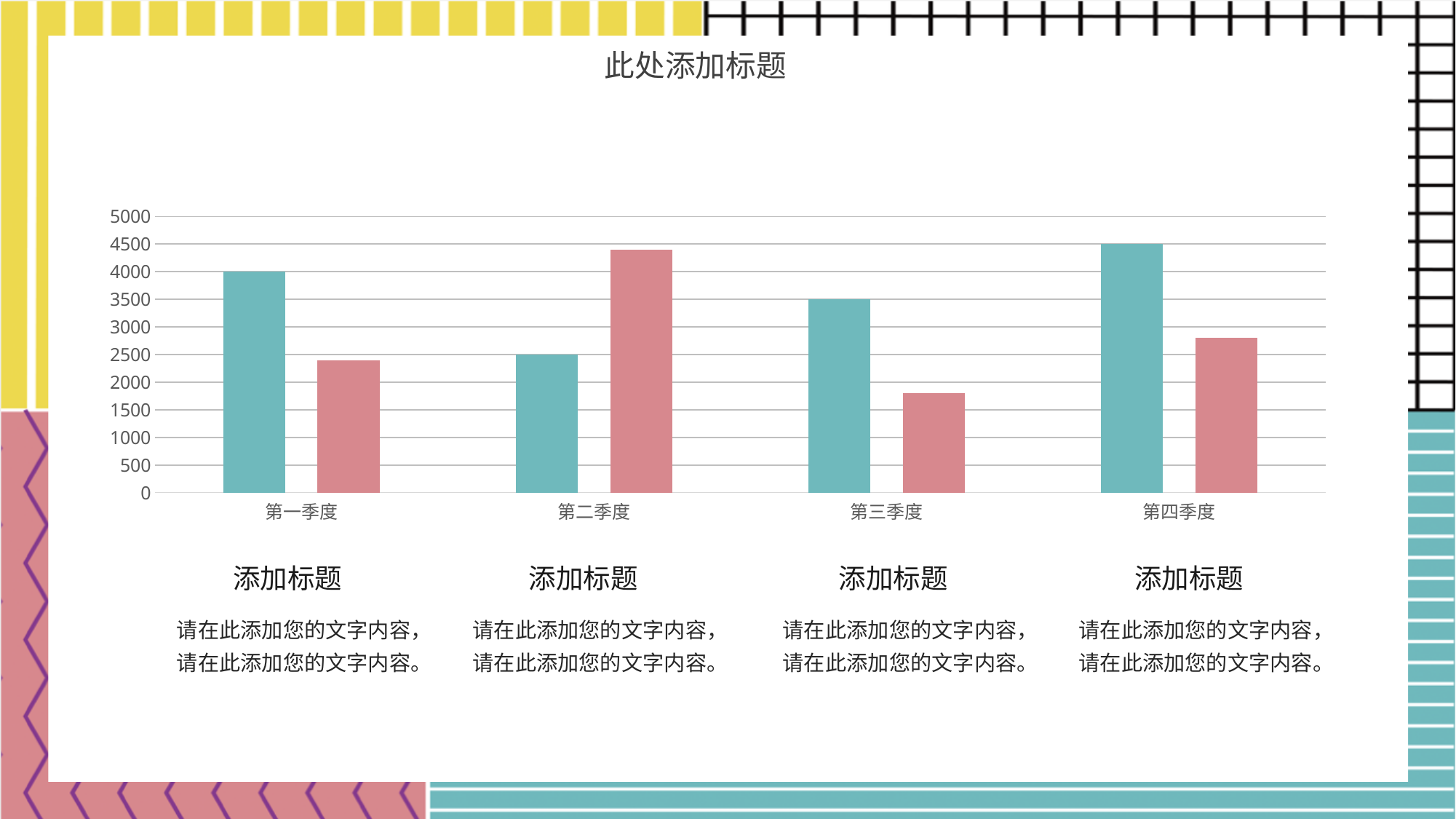
Which category has the highest pink bar? 第二季度 What is the value of the teal bar for 第二季度? 2500 What is the value of the teal bar for 第四季度? 4500 For 第一季度, which bar is taller, the teal bar or the pink bar? the teal bar Which category has the highest teal bar? 第四季度 What kind of chart is shown on the slide? bar chart Which category has the lowest teal bar? 第二季度 Is the value of the pink bar for 第三季度 greater or less than 2000? less Is the value of the pink bar for 第二季度 greater or less than 4000? greater What is the value of the teal bar for 第一季度? 4000 What is the difference between the teal bar values for 第四季度 and 第二季度? 2000 How many categories are shown on the x axis of the chart? 4